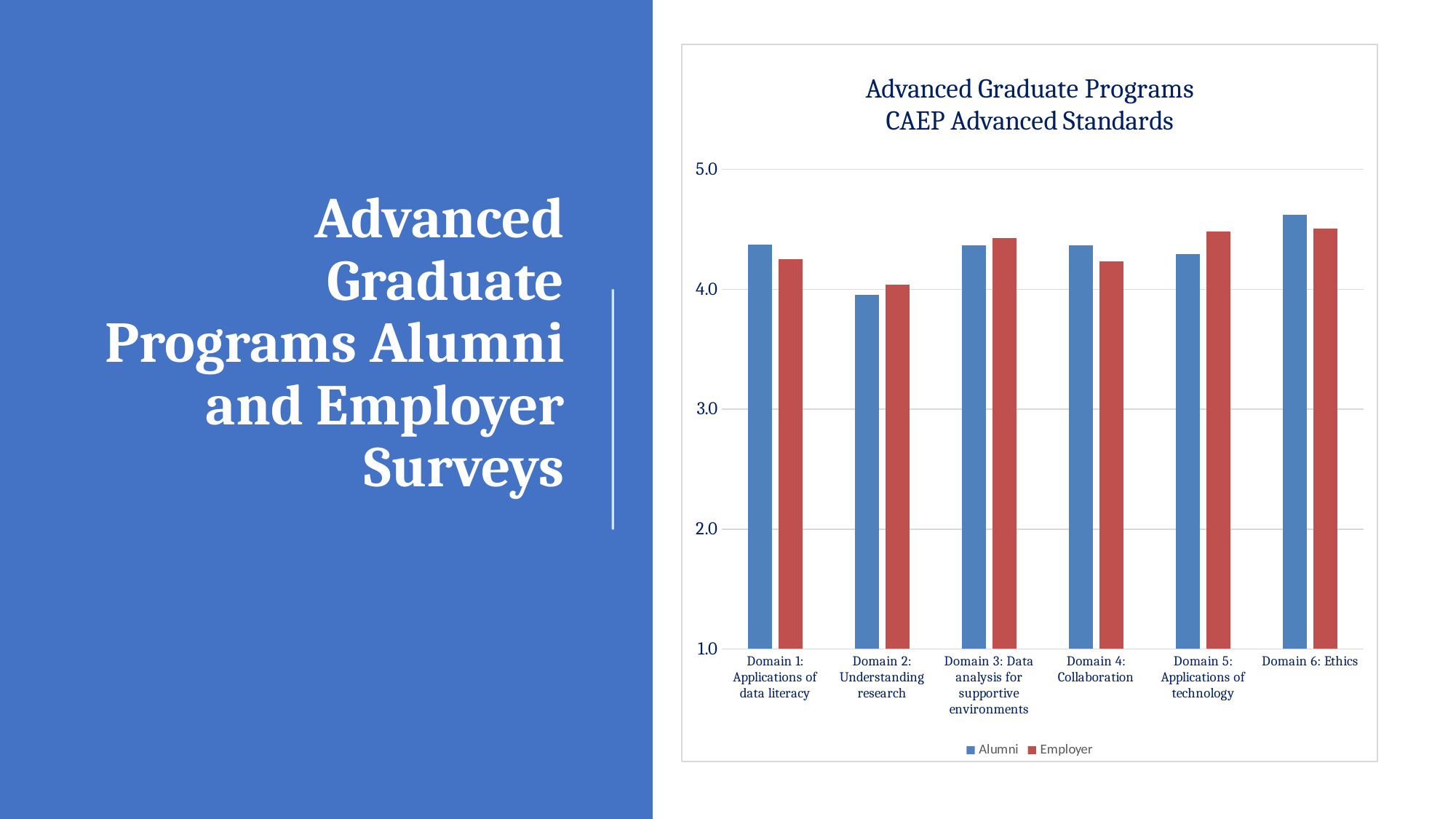
What is the title of the chart? Advanced Graduate Programs CAEP Advanced Standards Is the Alumni value for Domain 2: Understanding research greater or less than 4.0? less What kind of chart is shown on the slide? Bar chart For Domain 5: Applications of technology, which is larger, the Alumni value or the Employer value? Employer For Domain 4: Collaboration, which is larger, the Alumni value or the Employer value? Alumni Which domain has the lowest Employer value? Domain 2: Understanding research How many domains (categories) are shown on the x axis of the chart? 6 Which domain has the lowest Alumni value? Domain 2: Understanding research Which colour represents the Employer series in the chart? Red Which domain has the highest Alumni value? Domain 6: Ethics How many series does the chart's legend list? 2 Is the Alumni value for Domain 6: Ethics greater or less than 4.0? greater